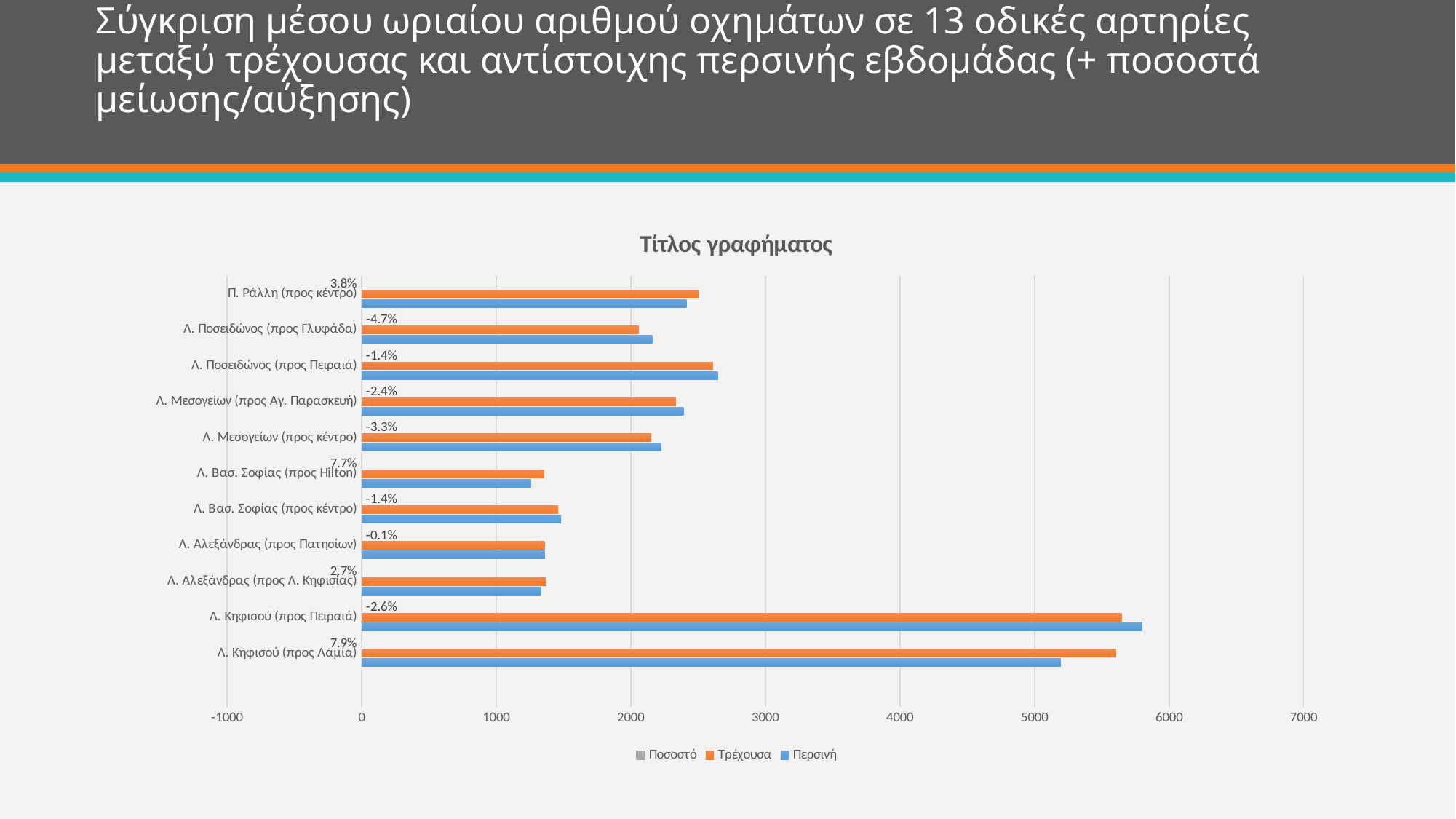
For Λ. Κηφισού (προς Πειραιά), which is larger: the Τρέχουσα value or the Περσινή value? Περσινή How many road categories are plotted on the chart? 11 What percentage is printed for Λ. Ποσειδώνος (προς Γλυφάδα)? -4.7% Which category has the lowest printed percentage? Λ. Ποσειδώνος (προς Γλυφάδα) What percentage is printed for Λ. Κηφισού (προς Λαμία)? 7.9% Is the Περσινή value for Λ. Κηφισού (προς Πειραιά) greater or less than 5000? greater What is the title shown above the chart? Τίτλος γραφήματος What kind of chart is shown on the slide? Bar chart How many series does the legend list? 3 Is the Περσινή value for Λ. Βασ. Σοφίας (προς Hilton) greater or less than 2000? less What percentage is printed for Λ. Αλεξάνδρας (προς Πατησίων)? -0.1% Which category has the highest printed percentage? Λ. Κηφισού (προς Λαμία)